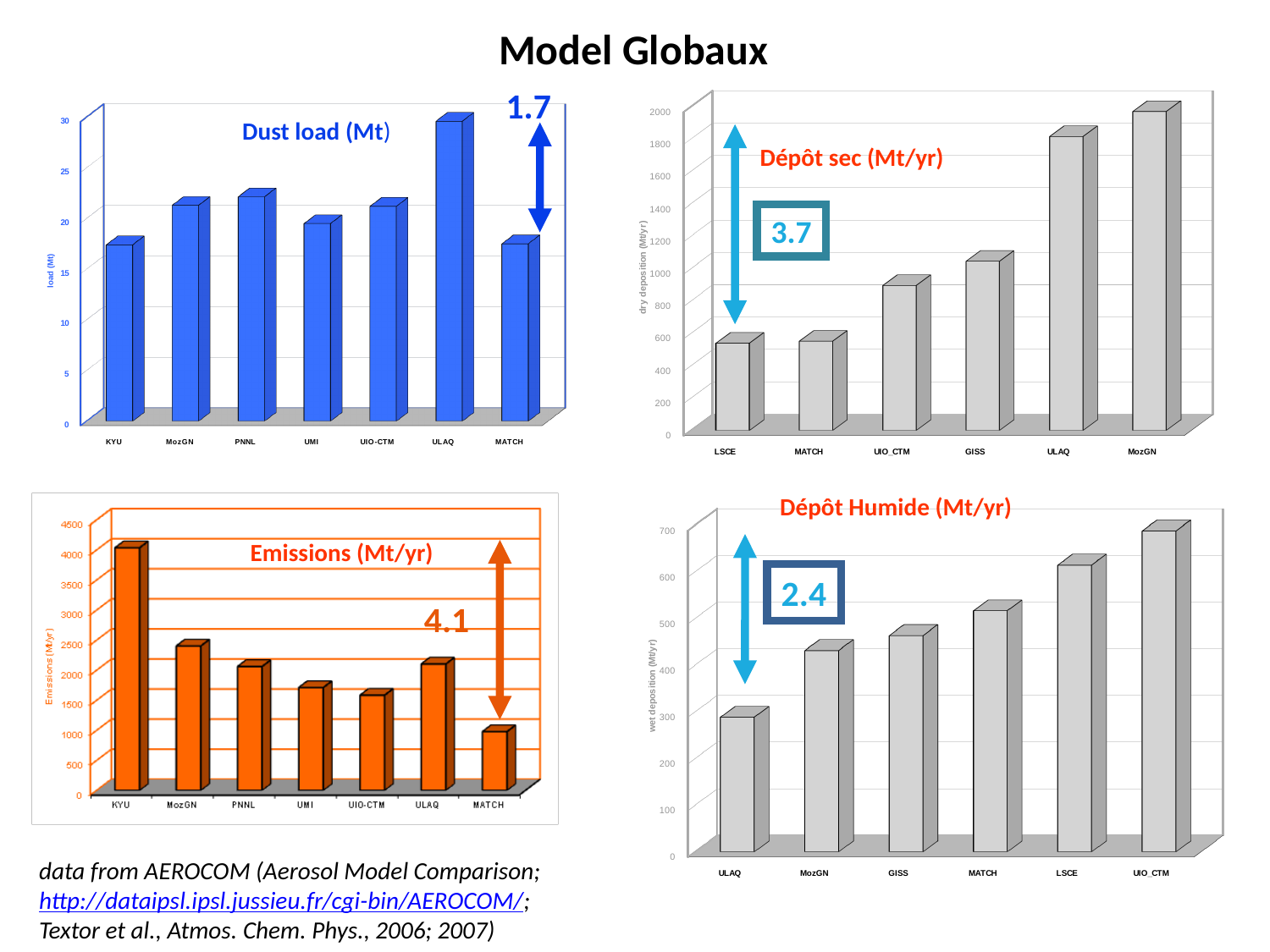
In the Dust load (Mt) chart, is the value for ULAQ greater or less than 25? greater In the Emissions (Mt/yr) chart, is the value for KYU greater or less than 3500? greater In the Dépôt sec (Mt/yr) chart, is the value for UIO_CTM greater or less than 1000? less In the Dépôt Humide (Mt/yr) chart, how many models are shown on the x axis? 6 In the Dust load (Mt) chart, how many models are shown on the x axis? 7 In the Dépôt Humide (Mt/yr) chart, which model has the lowest wet deposition? ULAQ In the Emissions (Mt/yr) chart, which model has the lowest emissions? MATCH In the Emissions (Mt/yr) chart, which model has the highest emissions? KYU What kind of chart is the Dépôt Humide (Mt/yr) chart? bar chart In the Dust load (Mt) chart, which model has the highest dust load? ULAQ In the Dépôt sec (Mt/yr) chart, which model has the highest dry deposition? MozGN In the Dépôt sec (Mt/yr) chart, do the values rise or fall from left to right along the x axis? rise